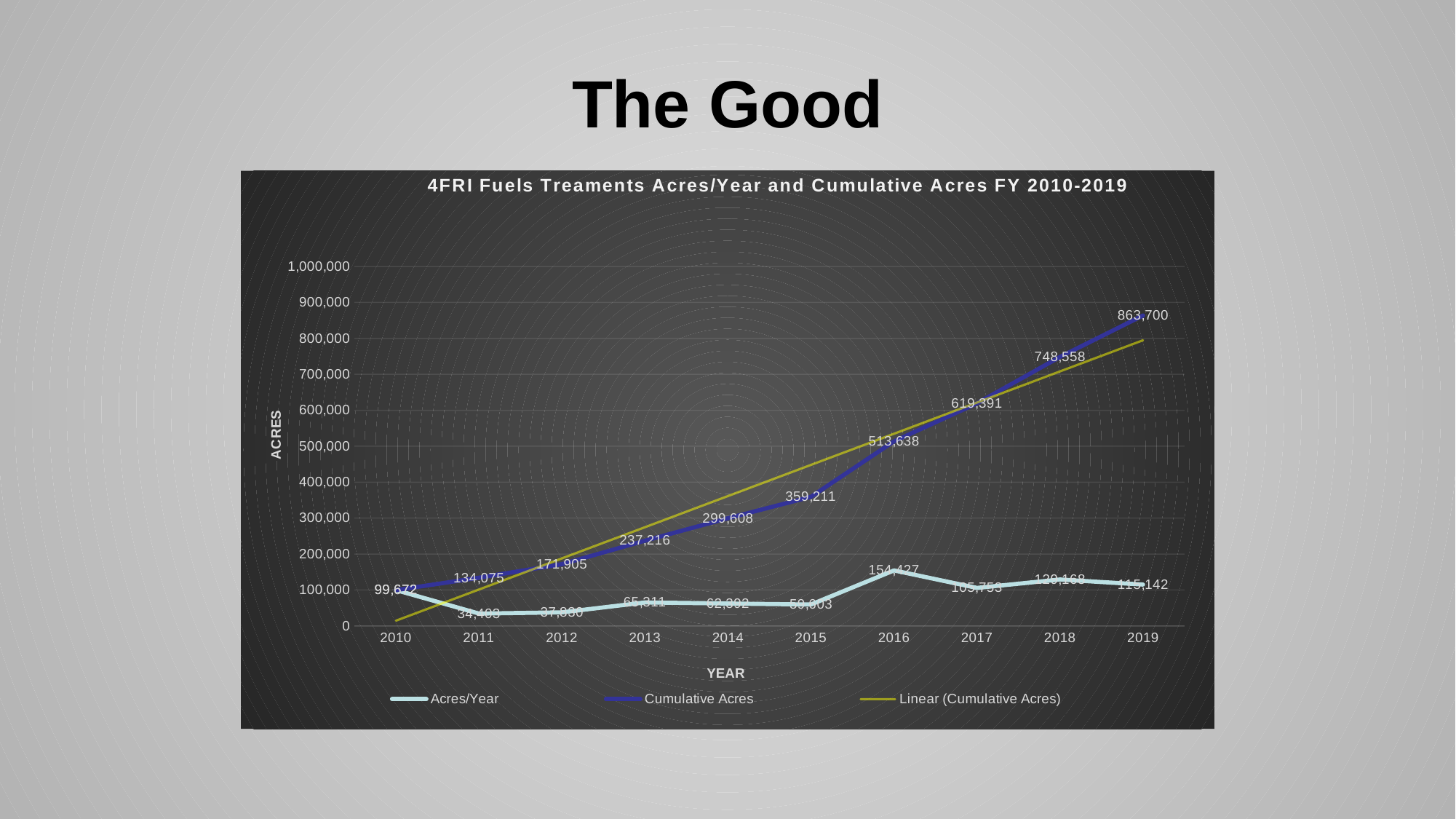
How many series does the legend list? 3 In which year is the Acres/Year value highest? 2016 What is the difference between the Cumulative Acres values for 2016 and 2015? 154,427 What is the Acres/Year value for 2019? 115,142 Is the Acres/Year value for 2012 greater or less than 100,000? less What kind of chart is shown on the slide? line chart What is the difference between the Cumulative Acres values for 2019 and 2018? 115,142 What is the Cumulative Acres value for 2016? 513,638 What is the Cumulative Acres value for 2013? 237,216 How many years are shown on the x axis? 10 What is the Cumulative Acres value for 2019? 863,700 Which year has the larger Cumulative Acres value, 2017 or 2018? 2018